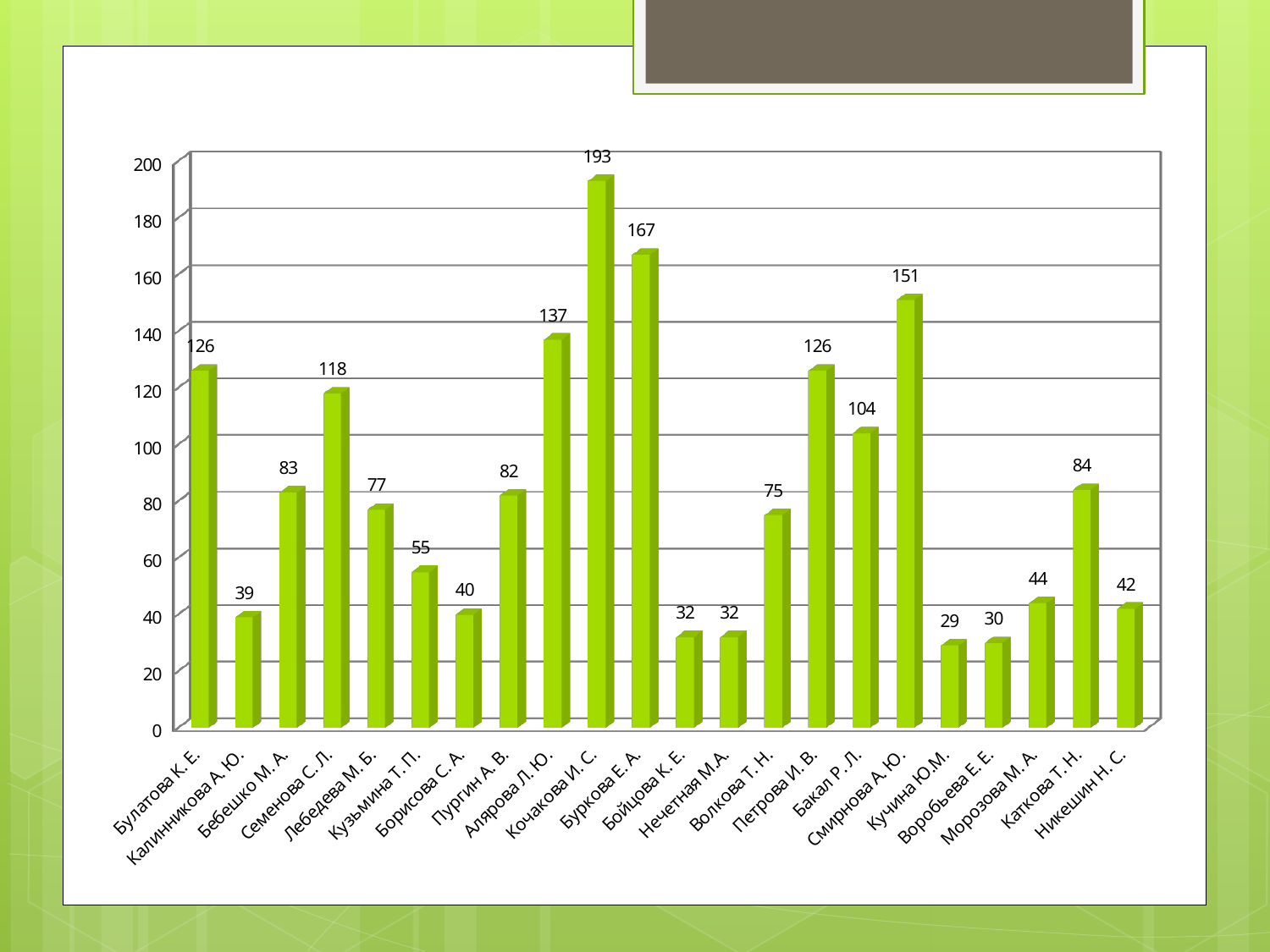
What is the value for Кузьмина Т. П.? 55 Which category has the highest value? Кочакова И. С. Which category has the lowest value? Кучина Ю.М. What is the value for Кочакова И. С.? 193 What is the difference between the values for Семенова С. Л. and Бебешко М. А.? 35 Which is larger, the value for Алярова Л. Ю. or the value for Петрова И. В.? Алярова Л. Ю. Which is larger, the value for Бакал Р. Л. or the value for Каткова Т. Н.? Бакал Р. Л. How many categories are shown on the x axis? 22 What colour are the bars in the chart? Green What is the value for Смирнова А. Ю.? 151 What is the difference between the values for Кочакова И. С. and Буркова Е. А.? 26 What kind of chart is shown on the slide? Bar chart